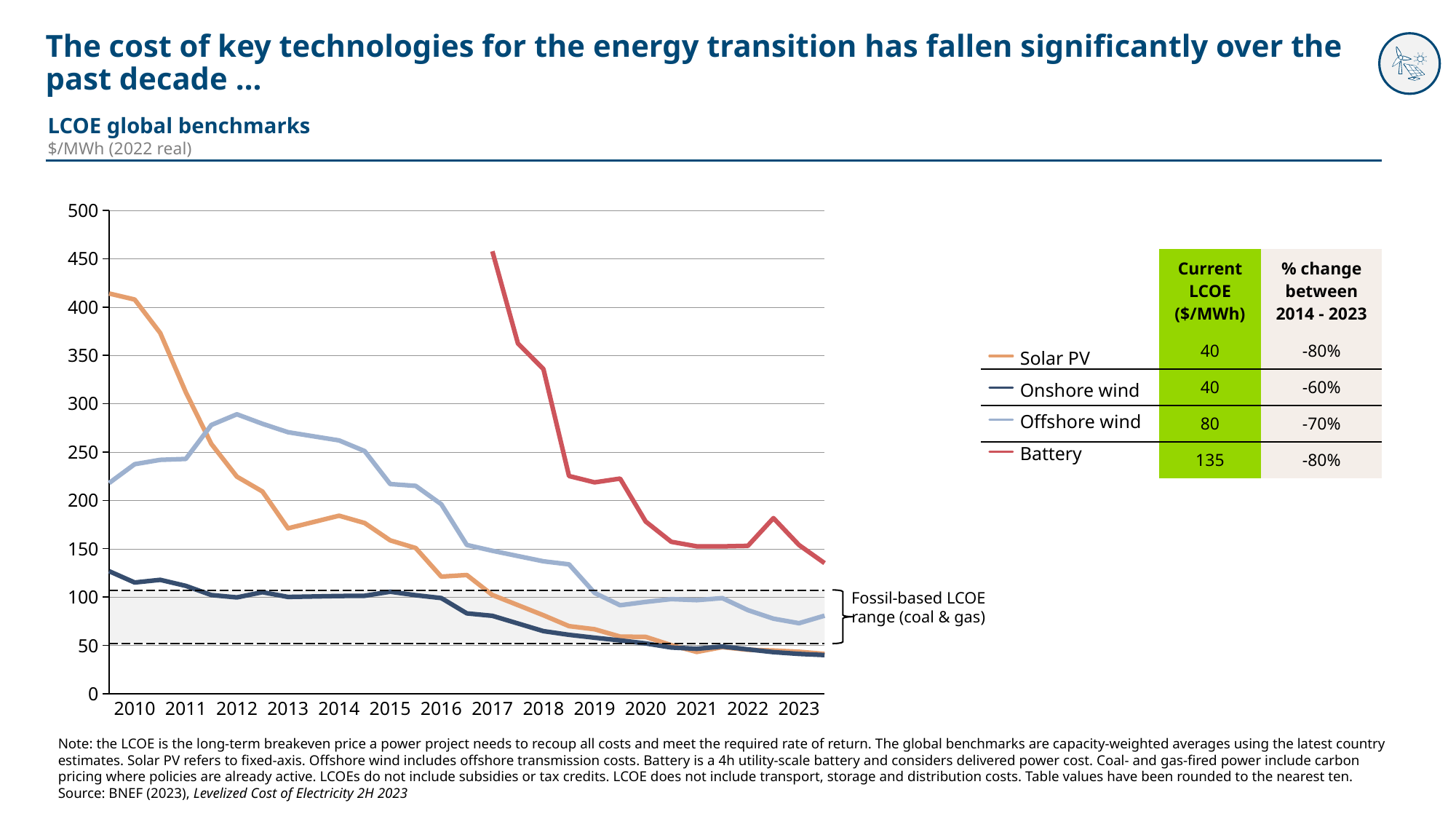
According to the table, what is the % change between 2014 - 2023 for Solar PV? -80% What kind of chart is shown on the slide? line chart Which technology has the highest current LCOE in the table? Battery What is the difference between the current LCOE of Battery and Solar PV in the table? 95 How many series does the legend list? 4 Is the value for Solar PV in 2010 greater or less than 400? greater Does the Solar PV line rise or fall from 2010 to 2023? fall In 2012, which is larger: Offshore wind or Solar PV? Offshore wind Is the value for Offshore wind in 2023 greater or less than 100? less How many years are shown on the x axis? 14 According to the table, what is the current LCOE ($/MWh) for Offshore wind? 80 According to the table, what is the current LCOE ($/MWh) for Battery? 135